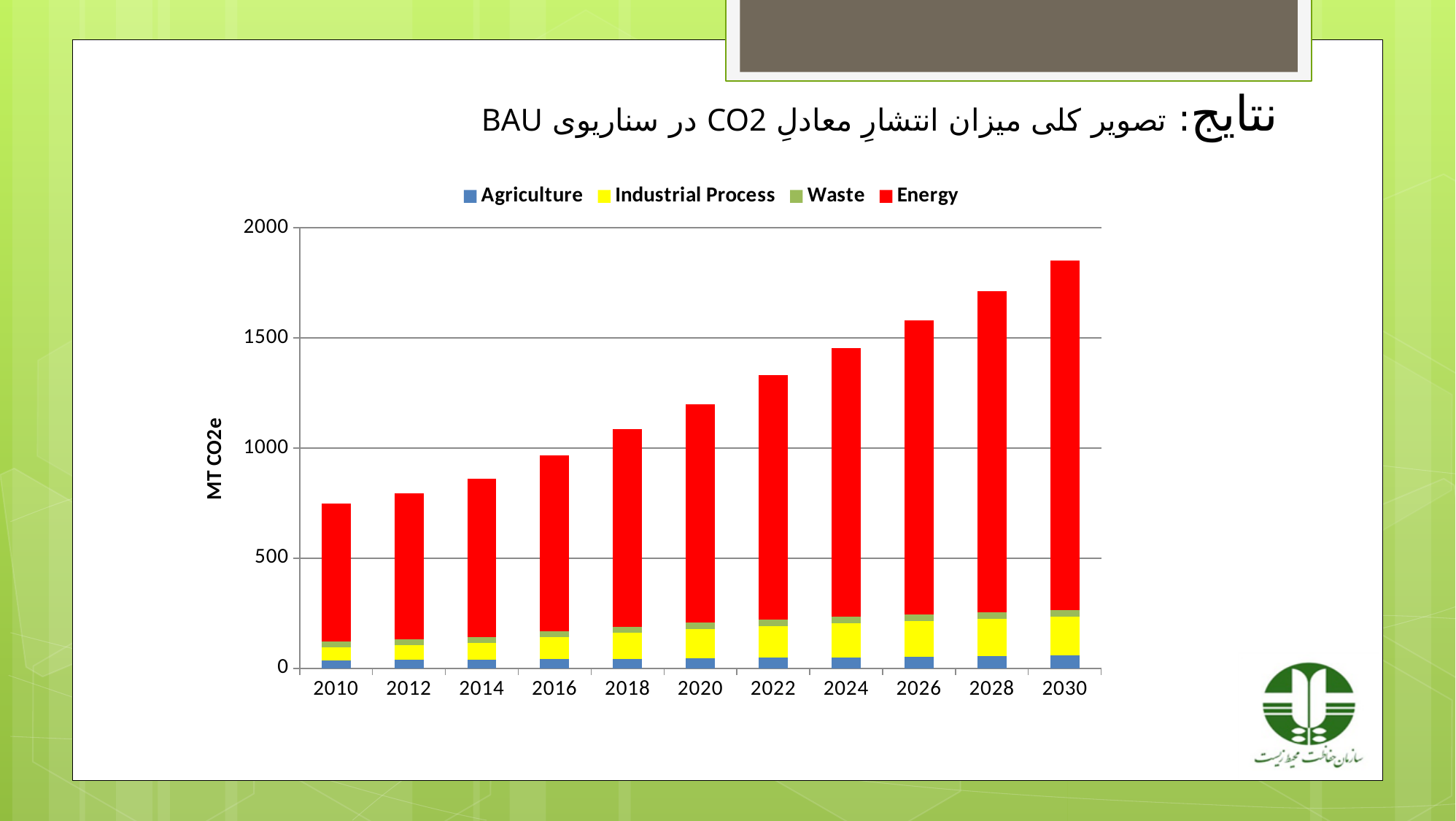
How many series does the legend list? 4 Which year has the lowest total emissions? 2010 How many years are shown on the x axis? 11 Do total emissions rise or fall from 2010 to 2030? rise Which series accounts for the largest part of each bar? Energy What kind of chart is shown on the slide? stacked bar chart What is the label on the y axis? MT CO2e Is the total for 2030 greater or less than 1500? greater Is the total for 2020 greater or less than 1000? greater Which year has the highest total emissions? 2030 Is the total for 2010 greater or less than 1000? less